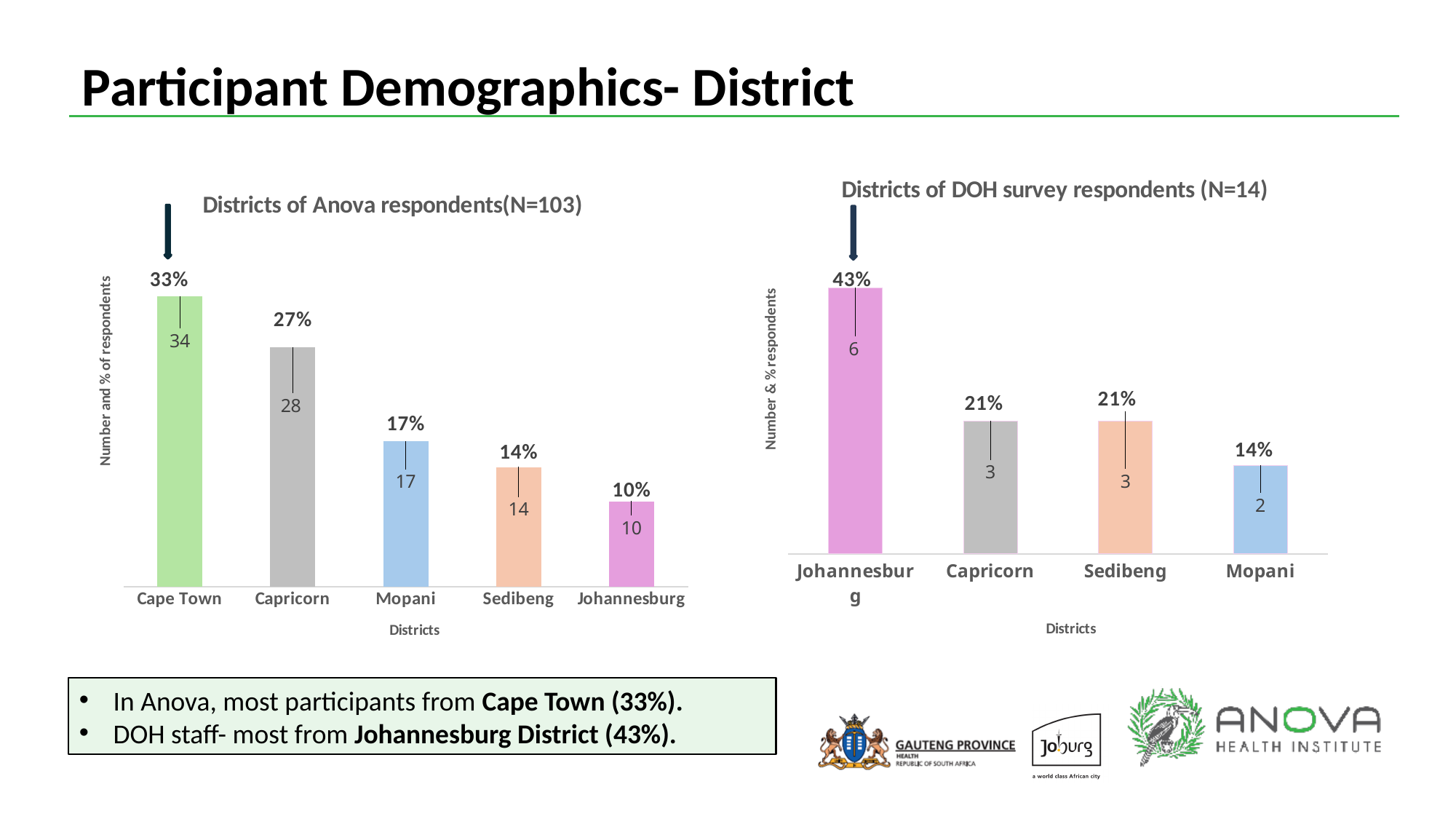
In the 'Districts of DOH survey respondents (N=14)' chart, how many districts are shown? 4 In the 'Districts of Anova respondents(N=103)' chart, what is the difference in number of respondents between Cape Town and Capricorn? 6 In the 'Districts of DOH survey respondents (N=14)' chart, which has more respondents, Capricorn or Mopani? Capricorn In the 'Districts of Anova respondents(N=103)' chart, how many districts are shown? 5 In the 'Districts of DOH survey respondents (N=14)' chart, what percentage of respondents are from Mopani? 14% In the 'Districts of DOH survey respondents (N=14)' chart, what is the difference in number of respondents between Johannesburg and Sedibeng? 3 What type of chart is the 'Districts of Anova respondents(N=103)' chart? Bar chart In the 'Districts of DOH survey respondents (N=14)' chart, which district has the highest number of respondents? Johannesburg In the 'Districts of DOH survey respondents (N=14)' chart, how many respondents are from Johannesburg? 6 In the 'Districts of Anova respondents(N=103)' chart, how many respondents are from Cape Town? 34 In the 'Districts of Anova respondents(N=103)' chart, which district has the lowest number of respondents? Johannesburg In the 'Districts of Anova respondents(N=103)' chart, what percentage of respondents are from Mopani? 17%